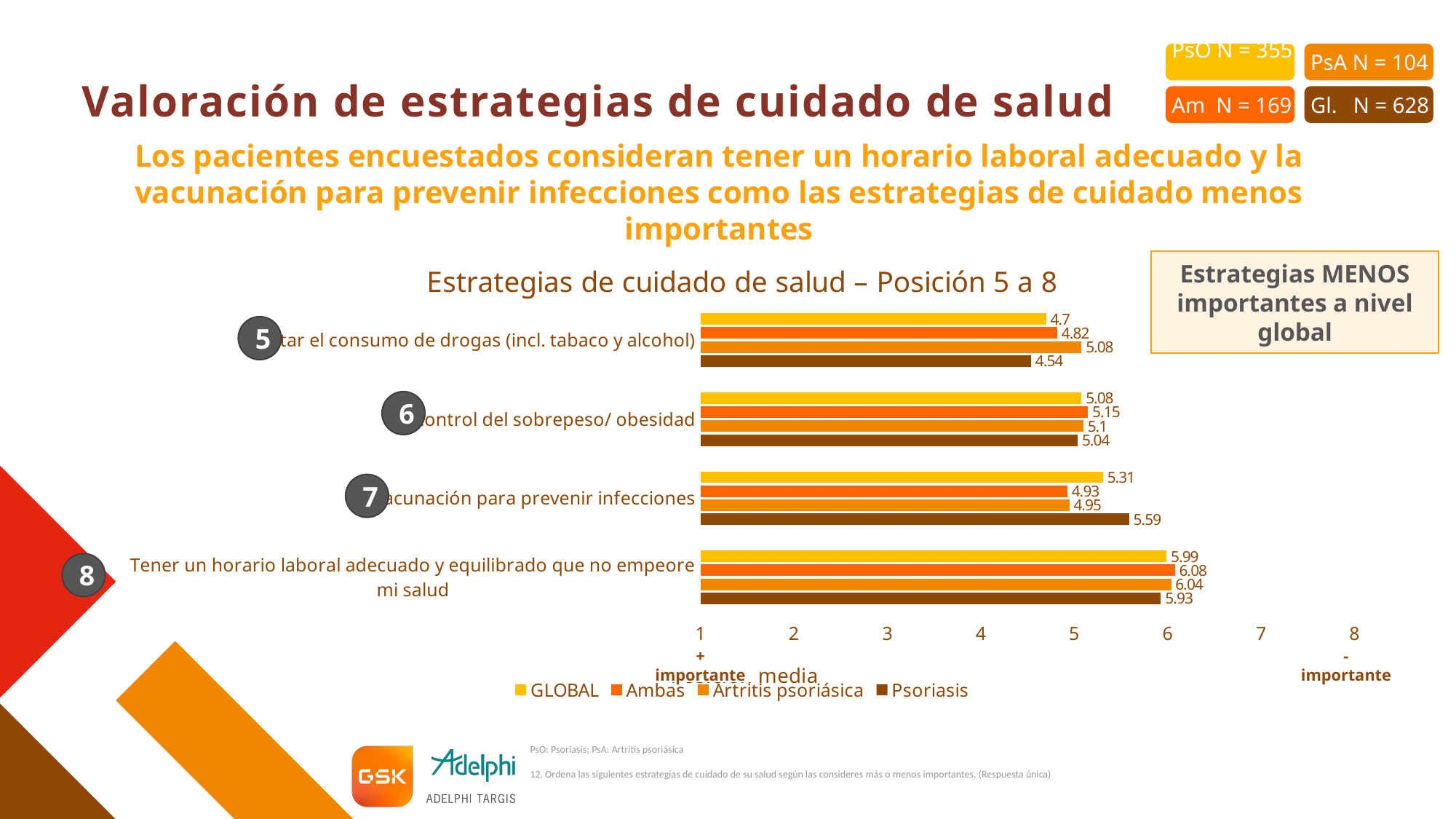
Which category has the highest GLOBAL value? Tener un horario laboral adecuado y equilibrado que no empeore mi salud What is the difference between the Psoriasis value and the Ambas value for 'vacunación para prevenir infecciones'? 0.66 What is the GLOBAL value for 'Tener un horario laboral adecuado y equilibrado que no empeore mi salud'? 5.99 For 'consumo de drogas (incl. tabaco y alcohol)', which is larger: the Artritis psoriásica value or the Psoriasis value? Artritis psoriásica Which category has the lowest Psoriasis value? Evitar el consumo de drogas (incl. tabaco y alcohol) What is the Ambas value for 'control del sobrepeso/ obesidad'? 5.15 Is the Ambas value for 'Tener un horario laboral adecuado y equilibrado que no empeore mi salud' greater or less than 6? greater How many categories (strategies) are plotted in the chart? 4 What is the Psoriasis value for 'vacunación para prevenir infecciones'? 5.59 How many series does the chart legend list? 4 What is the title of the chart? Estrategias de cuidado de salud – Posición 5 a 8 What type of chart is shown on the slide? bar chart